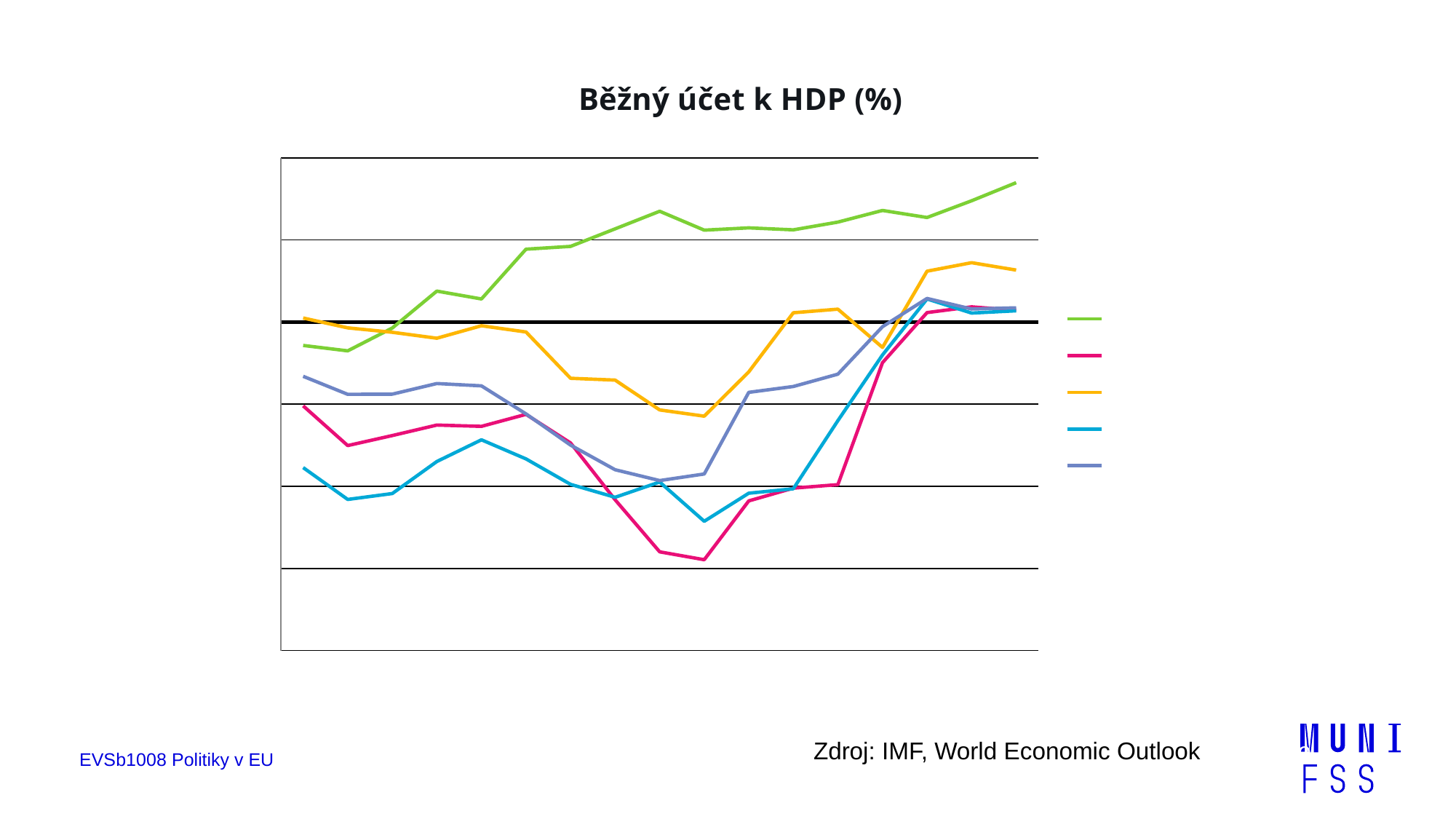
How many series does the legend list? 5 What is the source cited below the chart? IMF, World Economic Outlook Which coloured line is the highest at the right end of the chart? green At the right end of the chart, is the green line or the orange line higher? green Does the green line generally rise or fall from left to right? rise What kind of chart is shown on the slide? line chart What is the title of the chart? Běžný účet k HDP (%) Which coloured line reaches the lowest point on the chart? pink